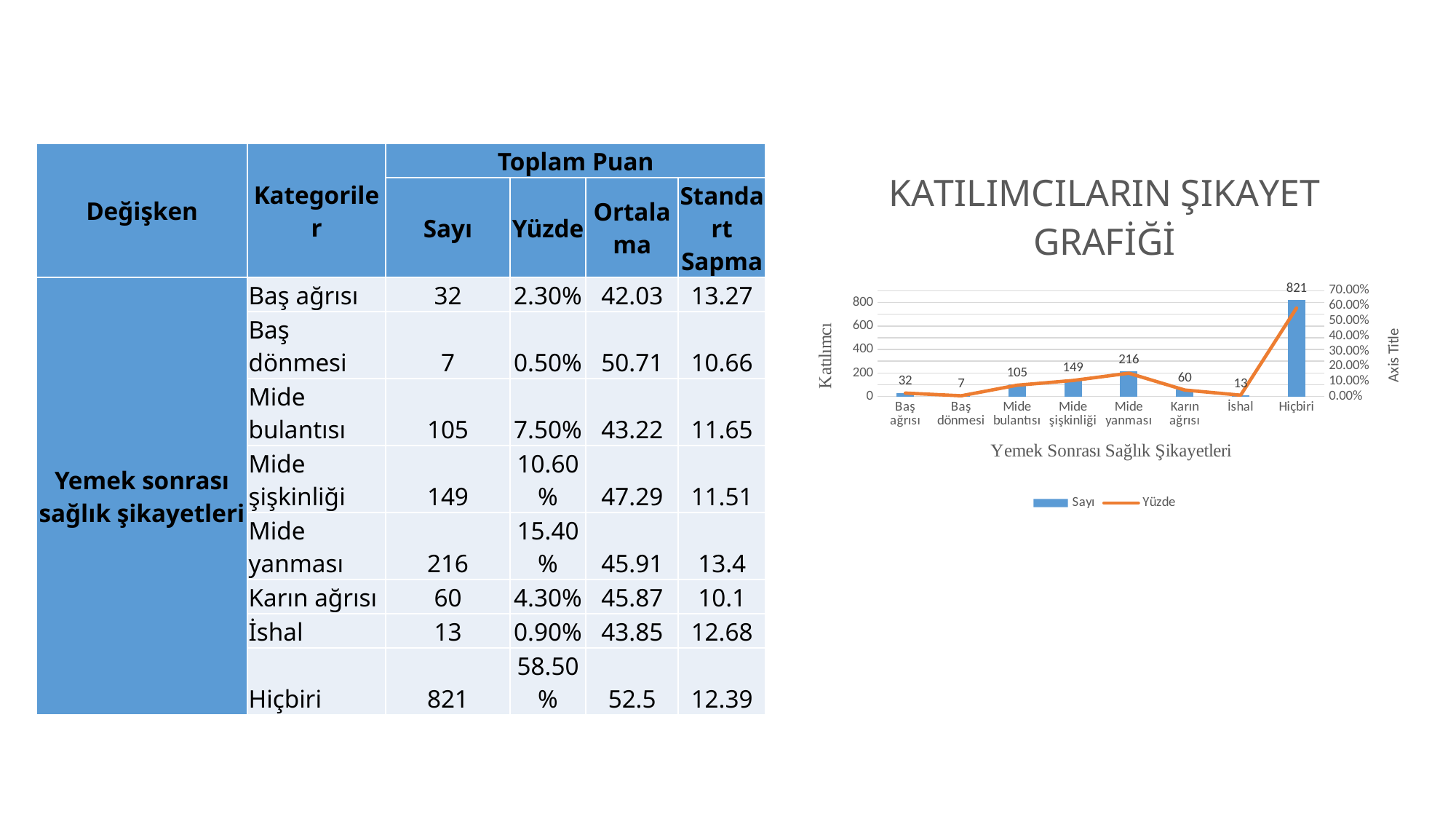
What is the Sayı value for Mide yanması in the chart? 216 What is the difference between the Sayı values for Mide şişkinliği and Mide bulantısı? 44 How many categories are shown on the x axis of the chart? 8 Which has a larger Sayı value, Baş ağrısı or İshal? Baş ağrısı Which category has the lowest Sayı value in the chart? Baş dönmesi How many series does the chart legend list? 2 What is the title of the chart? KATILIMCILARIN ŞIKAYET GRAFİĞİ What is the difference between the Sayı values for Hiçbiri and Mide yanması? 605 Which category has the highest Sayı value in the chart? Hiçbiri What is the Sayı value for Karın ağrısı in the chart? 60 What kind of chart is used for the Sayı series? Bar chart Is the Sayı value for Hiçbiri greater or less than 600? greater